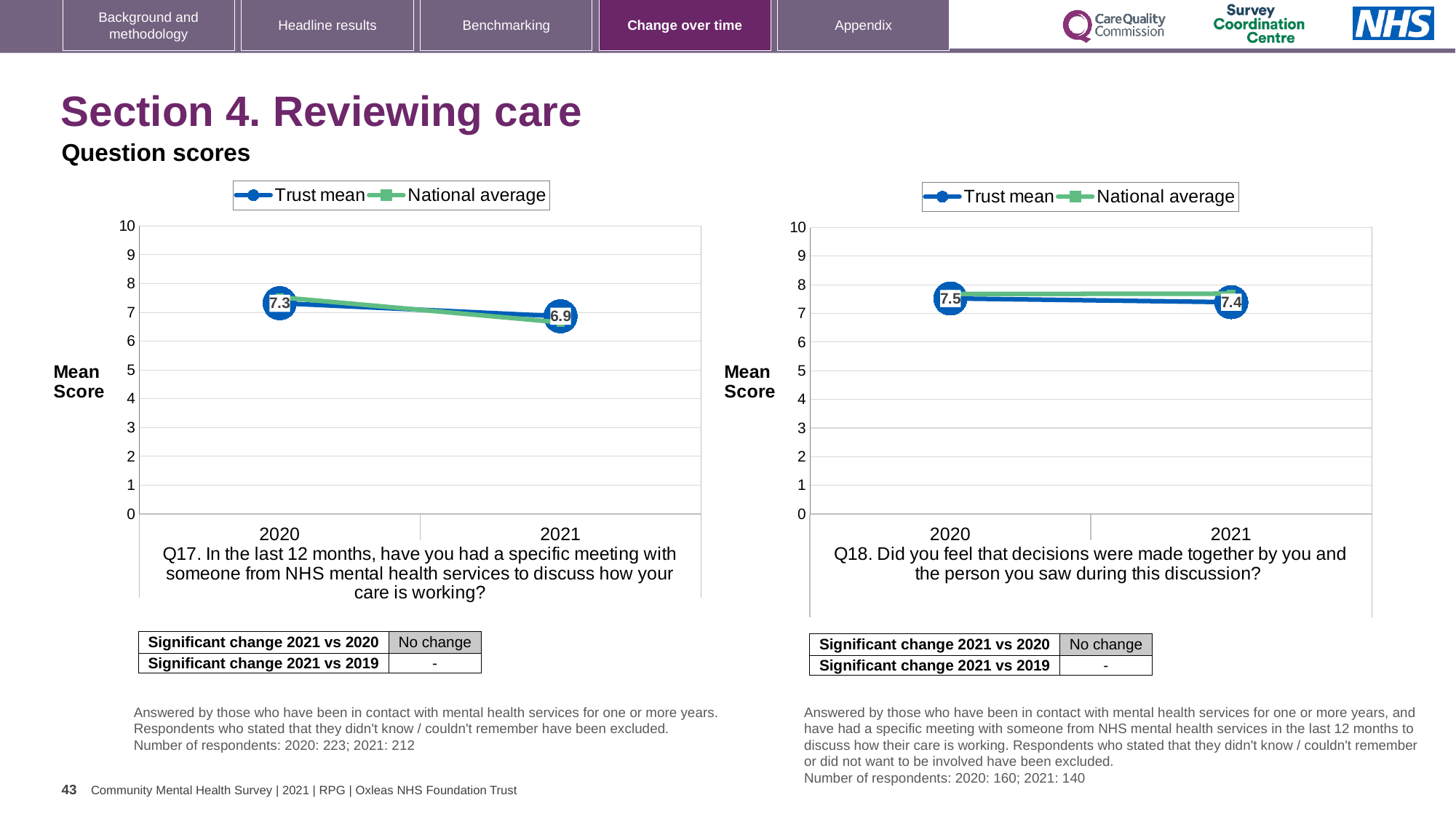
In the Q17 chart on the left, by how much did the Trust mean change from 2020 to 2021? 0.4 What type of chart is the Q18 chart on the right? line chart In the Q18 chart on the right, is the National average for 2021 greater or less than 5? greater How many series does the legend of the Q17 chart on the left list? 2 In the Q17 chart on the left, what is the Trust mean for 2021? 6.9 In the Q17 chart on the left, which year has the higher Trust mean, 2020 or 2021? 2020 In the Q18 chart on the right, what is the Trust mean for 2020? 7.5 In the Q18 chart on the right, what is the difference between the Trust mean in 2020 and in 2021? 0.1 In the Q18 chart on the right, what is the Trust mean for 2021? 7.4 In the Q17 chart on the left, does the Trust mean rise or fall from 2020 to 2021? fall How many years are shown on the x axis of the Q18 chart on the right? 2 In the Q17 chart on the left, what is the Trust mean for 2020? 7.3